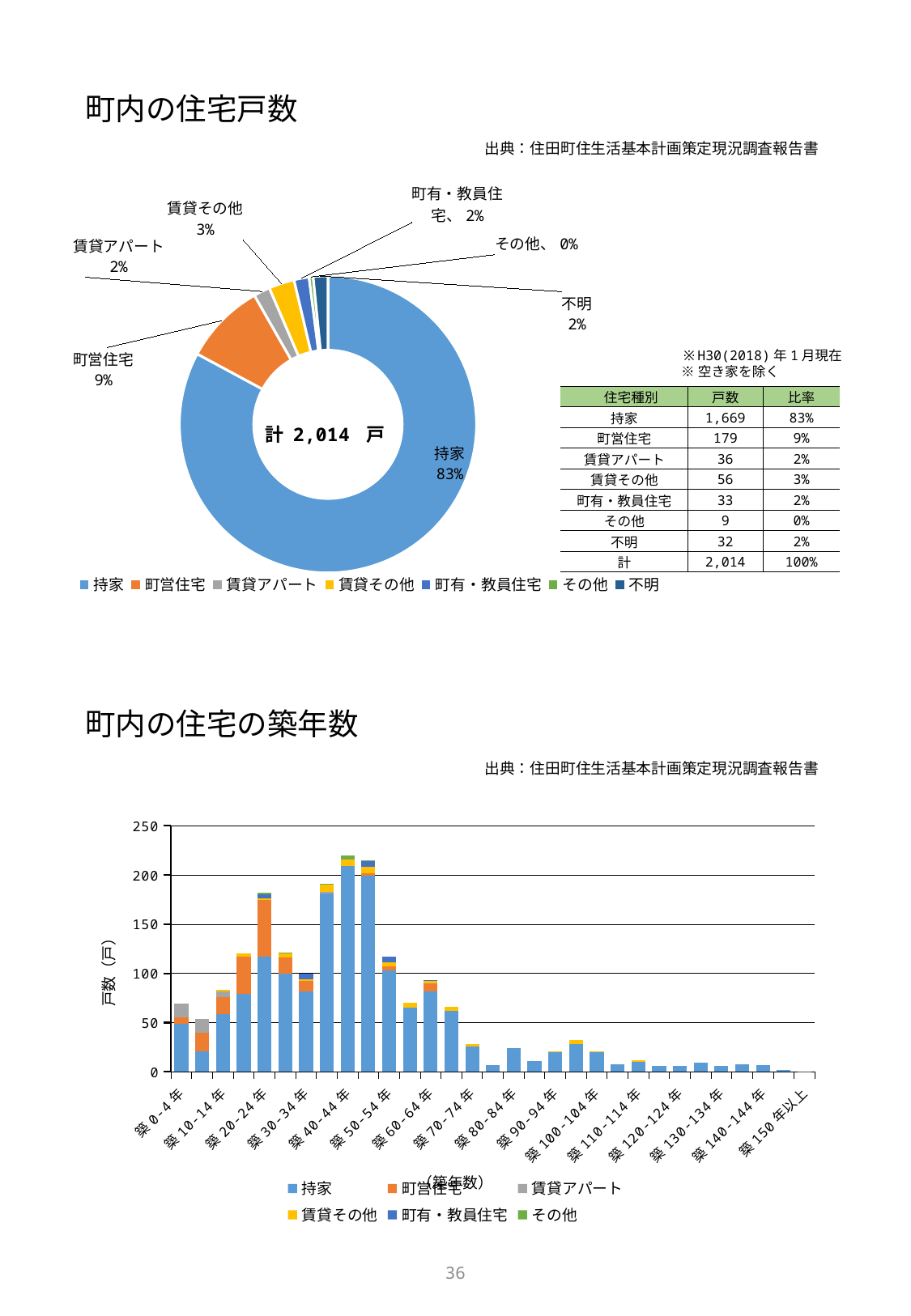
In the donut chart 町内の住宅戸数, which category has the smallest share? その他 In the donut chart 町内の住宅戸数, what share of the total is 賃貸その他? 3% What kind of chart is 町内の住宅の築年数? stacked bar chart In the donut chart 町内の住宅戸数, what total number of dwellings is shown in the centre? 2,014 戸 In the bar chart 町内の住宅の築年数, is the total for 築40-44年 greater or less than 200? greater How many series does the legend of the bar chart 町内の住宅の築年数 list? 6 In the donut chart 町内の住宅戸数, which category has the largest share? 持家 In the donut chart 町内の住宅戸数, what share of the total is 町営住宅? 9% In the bar chart 町内の住宅の築年数, is the total for 築0-4年 greater or less than 100? less How many entries does the legend of the donut chart 町内の住宅戸数 list? 7 In the donut chart 町内の住宅戸数, what share of the total is 持家? 83% In the bar chart 町内の住宅の築年数, which has the taller bar, 築20-24年 or 築60-64年? 築20-24年